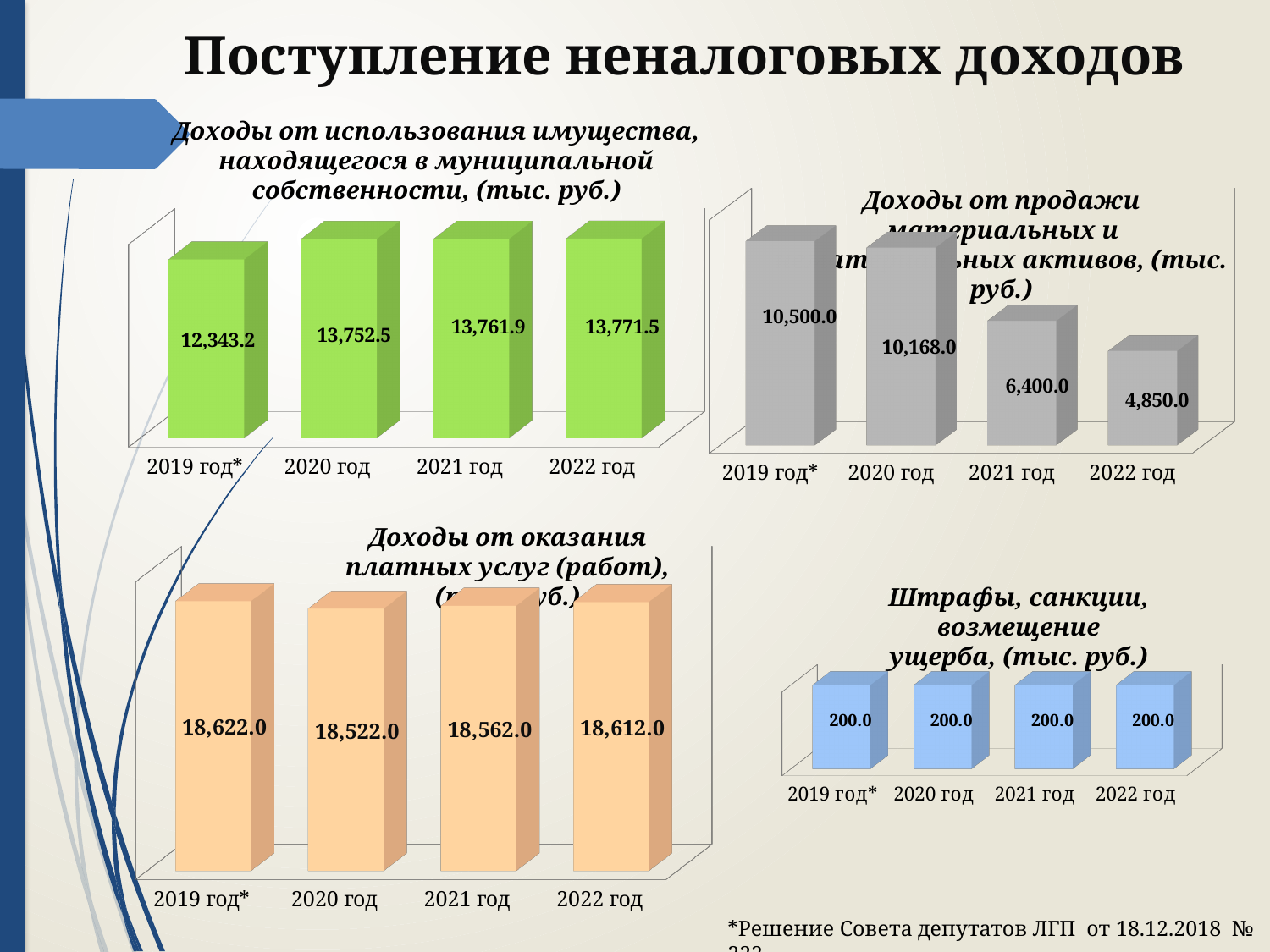
What type of chart is the top-left chart (Доходы от использования имущества)? bar chart In the bottom-right chart (Штрафы, санкции, возмещение ущерба), what is the value for 2020 год? 200.0 In the top-right chart (Доходы от продажи материальных и нематериальных активов), which year has the lowest value? 2022 год In the top-left chart (Доходы от использования имущества), what is the value for 2019 год*? 12,343.2 In the top-right chart (Доходы от продажи материальных и нематериальных активов), what is the difference between the 2019 год* and 2022 год values? 5,650.0 In the top-right chart (Доходы от продажи материальных и нематериальных активов), what is the value for 2021 год? 6,400.0 In the top-left chart (Доходы от использования имущества), which year has the highest value? 2022 год In the top-left chart (Доходы от использования имущества), what is the difference between the 2020 год and 2019 год* values? 1,409.3 How many years (categories) are shown in the bottom-right chart (Штрафы, санкции, возмещение ущерба)? 4 In the top-right chart (Доходы от продажи материальных и нематериальных активов), do the values rise or fall from 2019 to 2022? fall In the bottom-left chart (Доходы от оказания платных услуг), what is the value for 2022 год? 18,612.0 In the bottom-left chart (Доходы от оказания платных услуг), which year has the lowest value? 2020 год